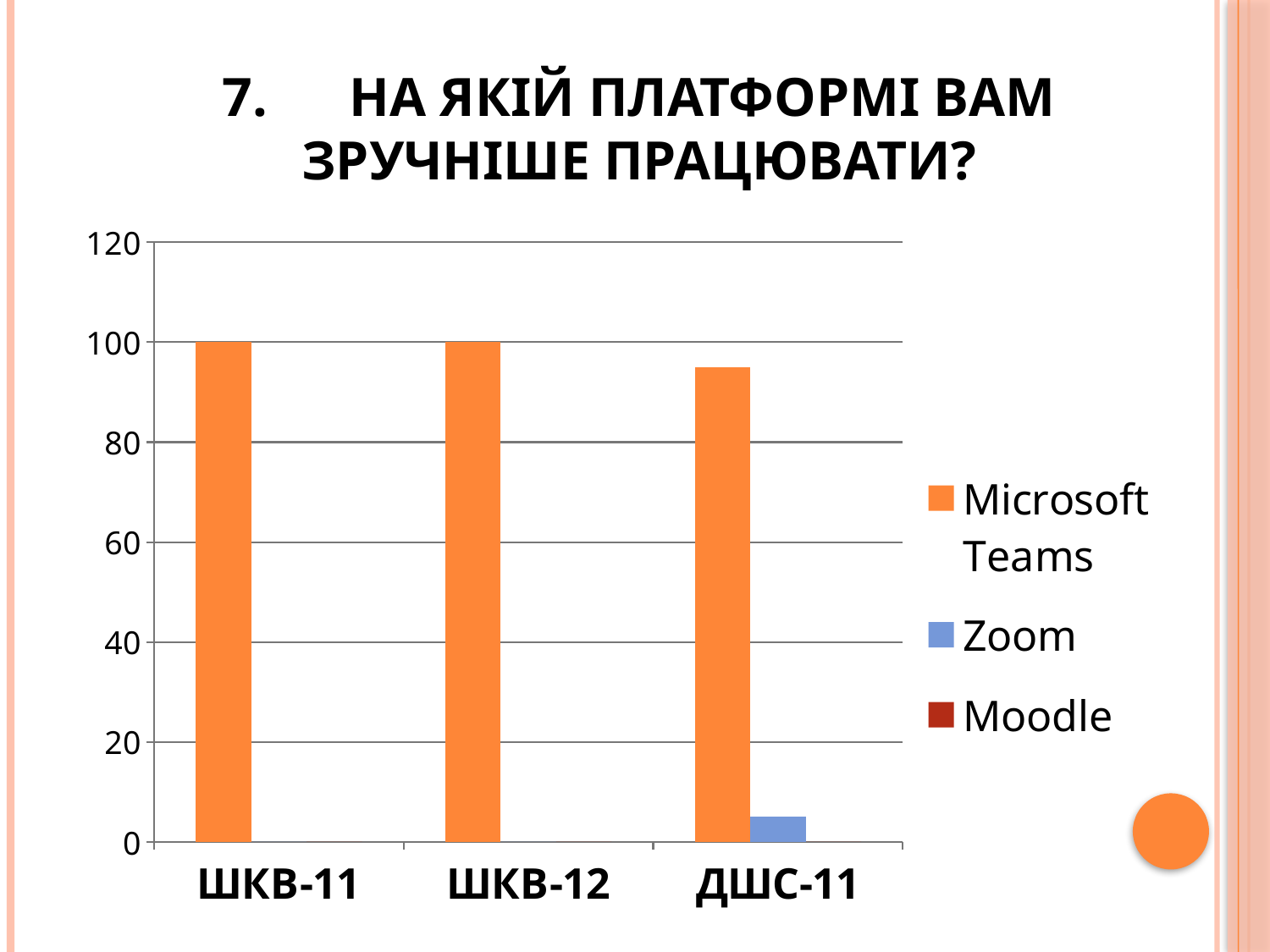
Is the value for Microsoft Teams in the ДШС-11 category greater or less than 100? less What is the value for Microsoft Teams in the ШКВ-11 category? 100 Which category has the lowest value for Microsoft Teams? ДШС-11 In the ДШС-11 category, which series has the larger value, Microsoft Teams or Zoom? Microsoft Teams What kind of chart is shown on the slide? Bar chart Is the value for Zoom in the ДШС-11 category greater or less than 20? less How many series does the chart's legend list? 3 Is the value for Microsoft Teams in the ДШС-11 category greater or less than 80? greater Which category has the larger Microsoft Teams value, ШКВ-11 or ДШС-11? ШКВ-11 What is the value for Microsoft Teams in the ШКВ-12 category? 100 How many categories are shown on the x axis of the chart? 3 What colour represents the Zoom series in the chart's legend? Blue